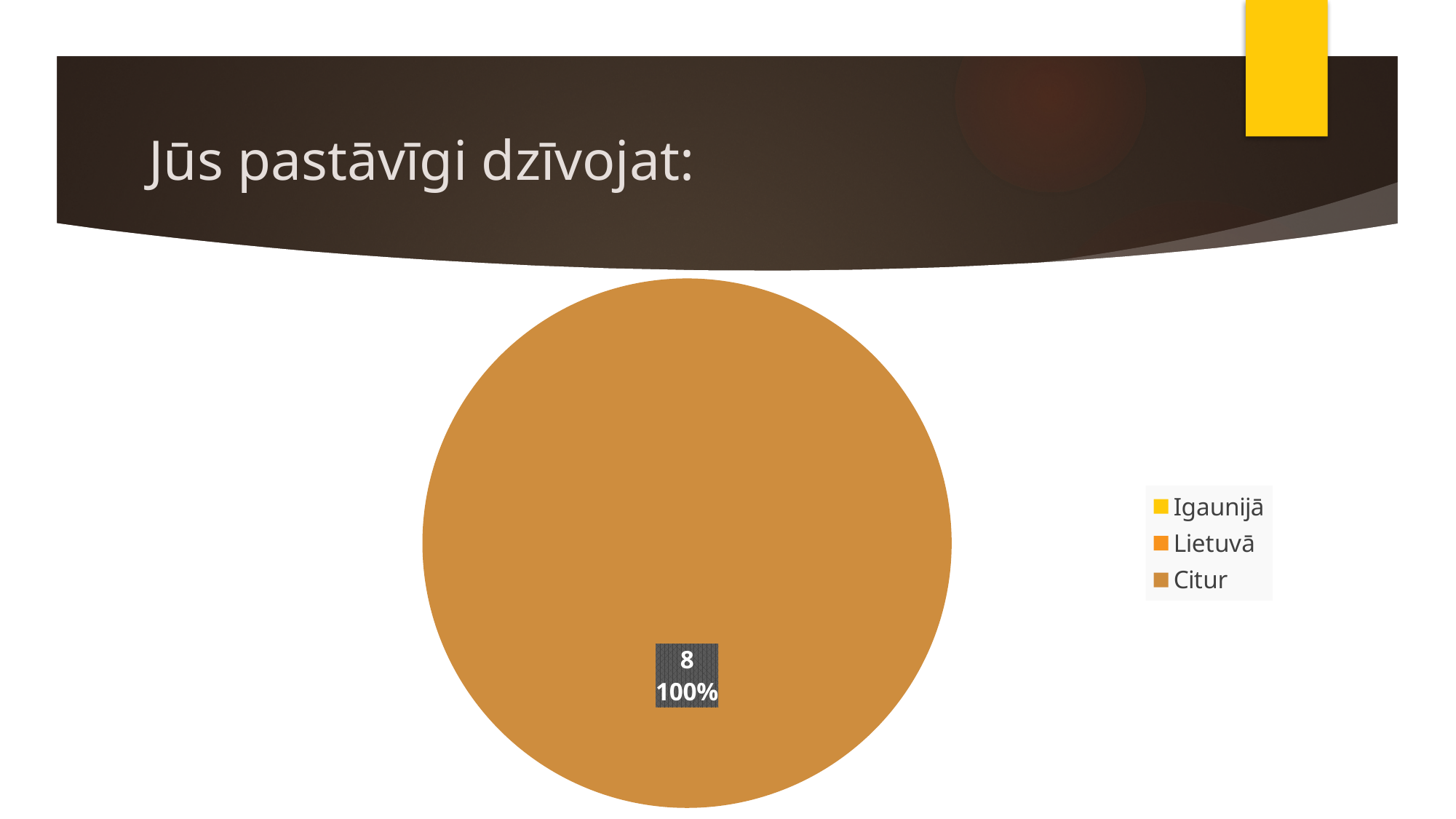
Which legend entry is shown with a yellow colour swatch? Igaunijā Which category has the largest slice of the pie? Citur How many entries does the legend list? 3 What is the value shown on the data label for Citur? 8 Which category is larger, Citur or Igaunijā? Citur What kind of chart is shown on the slide? pie chart What is the title of the slide containing the pie chart? Jūs pastāvīgi dzīvojat: What share of the pie does the Citur slice represent? 100%